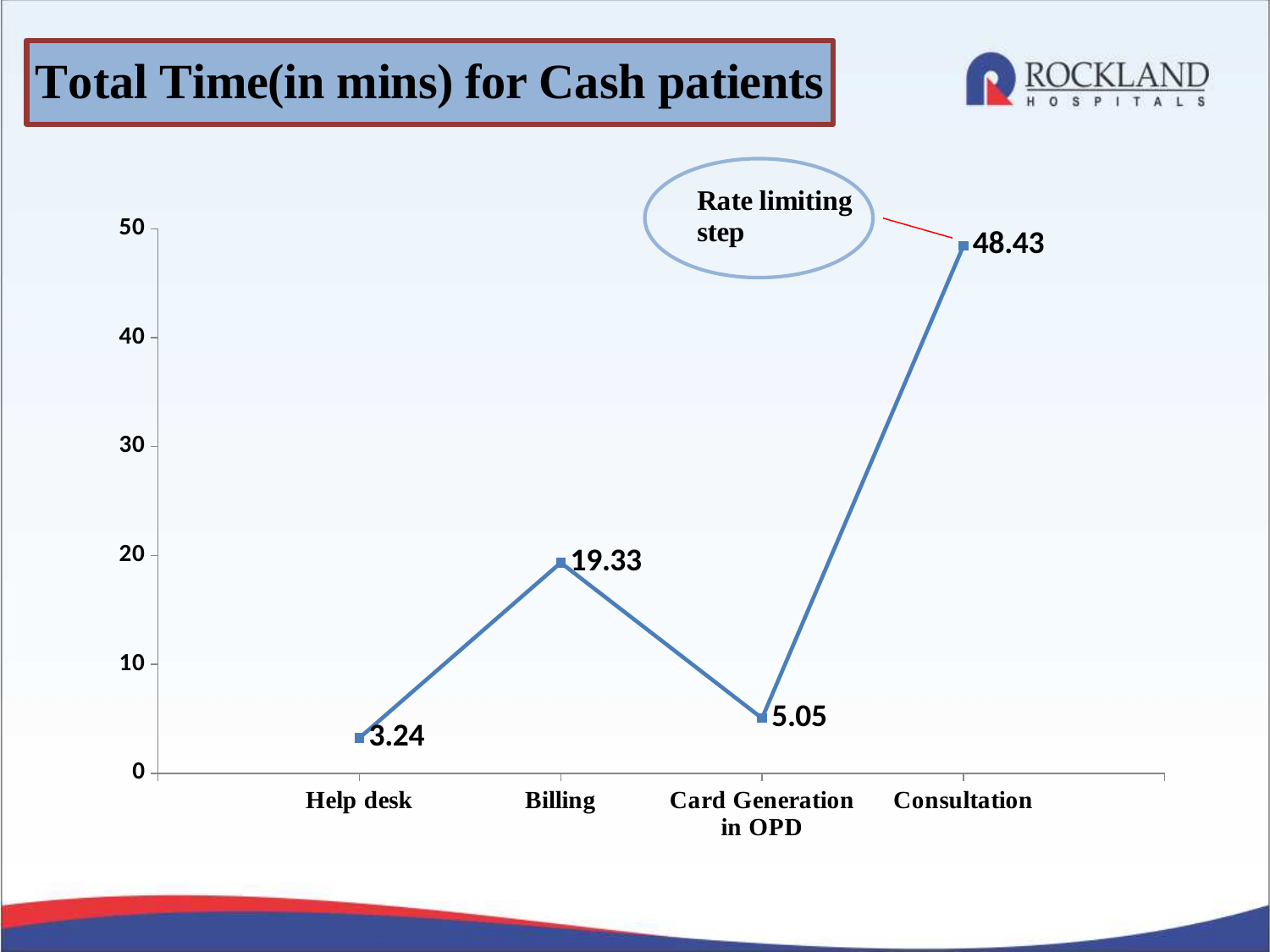
What is the value for Consultation? 48.43 Which is larger, the value for Billing or the value for Card Generation in OPD? Billing What kind of chart is shown on the slide? line chart Which step is labelled as the rate limiting step on the chart? Consultation Which category has the highest value? Consultation What is the value for Billing? 19.33 Is the value for Consultation greater or less than 40? greater What is the difference between the values for Consultation and Billing? 29.1 How many categories are plotted on the x axis? 4 Which category has the lowest value? Help desk What is the value for Card Generation in OPD? 5.05 What is the value for Help desk? 3.24